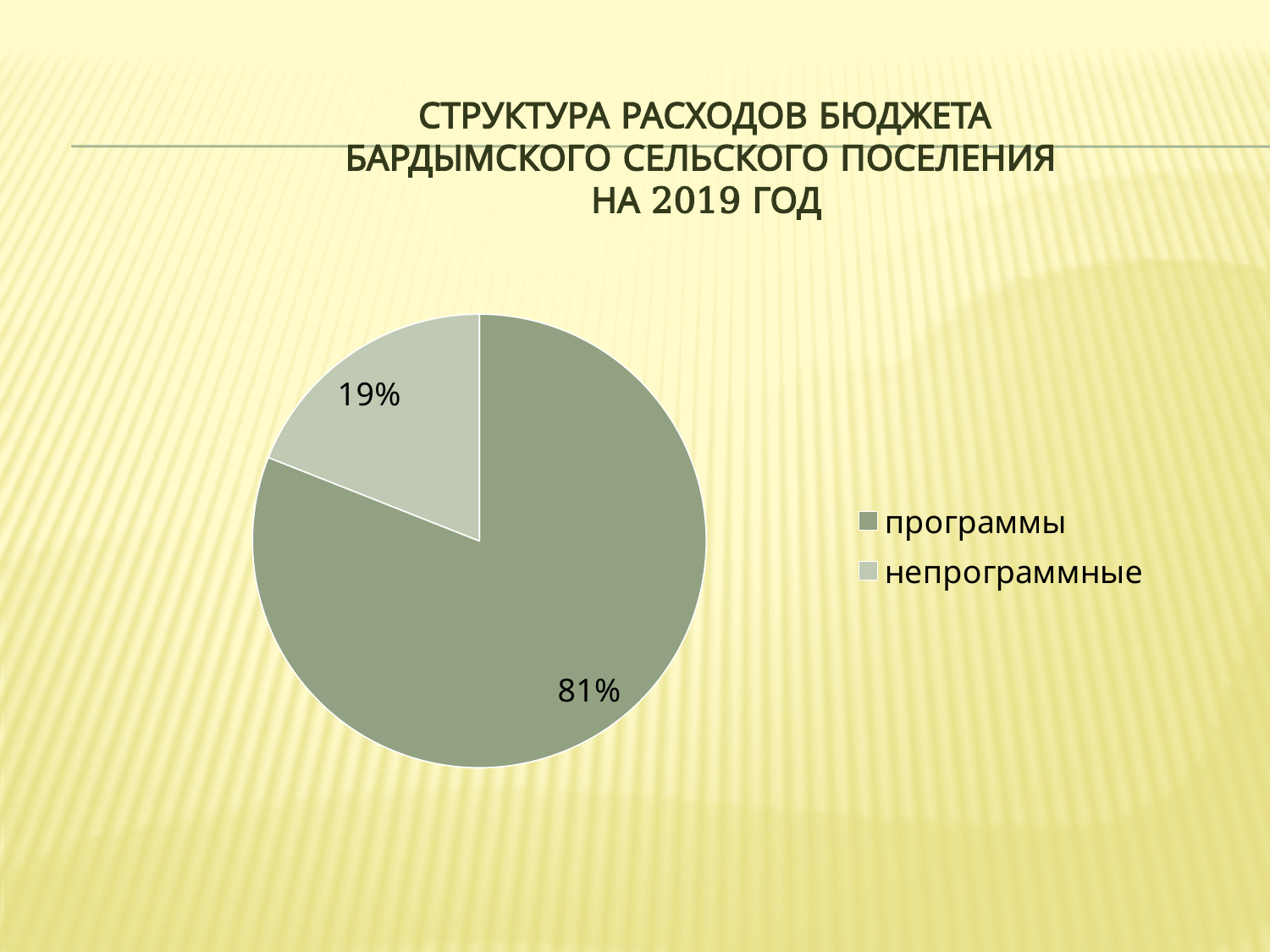
Which legend entry is shown with the lighter colour? непрограммные What kind of chart is shown on the slide? pie chart Which slice is the largest in the pie chart? программы How many entries does the legend list? 2 Which slice is the smallest in the pie chart? непрограммные How many slices does the pie chart have? 2 What share of the pie does the "программы" slice represent? 81% What share of the pie does the "непрограммные" slice represent? 19% Which is larger, the "программы" slice or the "непрограммные" slice? программы What is the difference in percentage points between the "программы" and "непрограммные" slices? 62 What year does the slide title say the budget expenditure structure is for? 2019